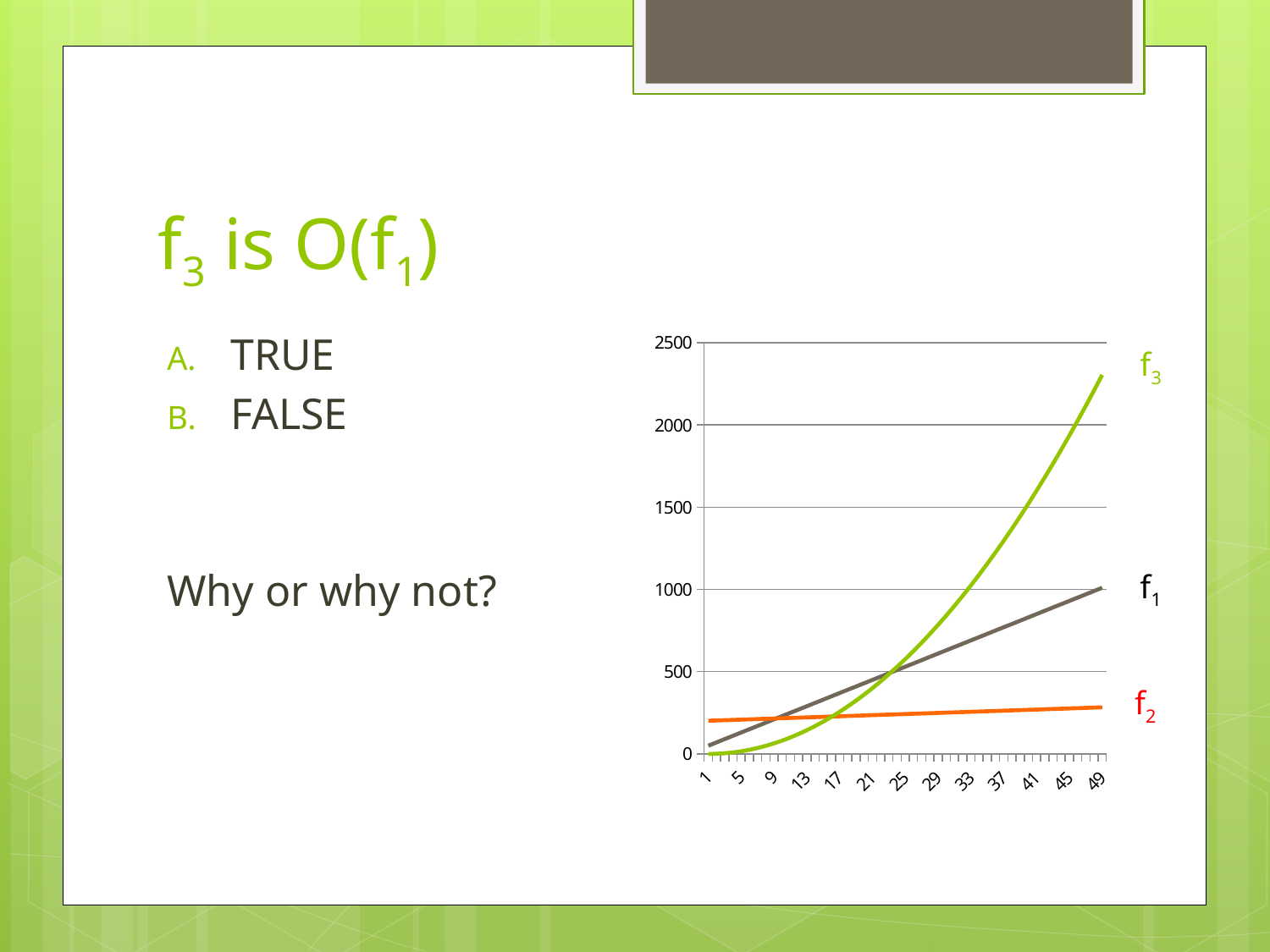
Which series has the lowest value at x = 1? f3 Does f3 rise or fall as x increases? rise How many series are plotted on the chart? 3 At x = 1, which is larger, f2 or f3? f2 Is the value of f1 at x = 49 greater or less than 500? greater What kind of chart is shown on the slide? line chart Is the value of f2 at x = 49 greater or less than 500? less At x = 49, which is larger, f3 or f1? f3 Which series has the highest value at x = 49? f3 What is the highest value shown on the vertical axis? 2500 Is the value of f3 at x = 49 greater or less than 2000? greater Which series has the lowest value at x = 49? f2